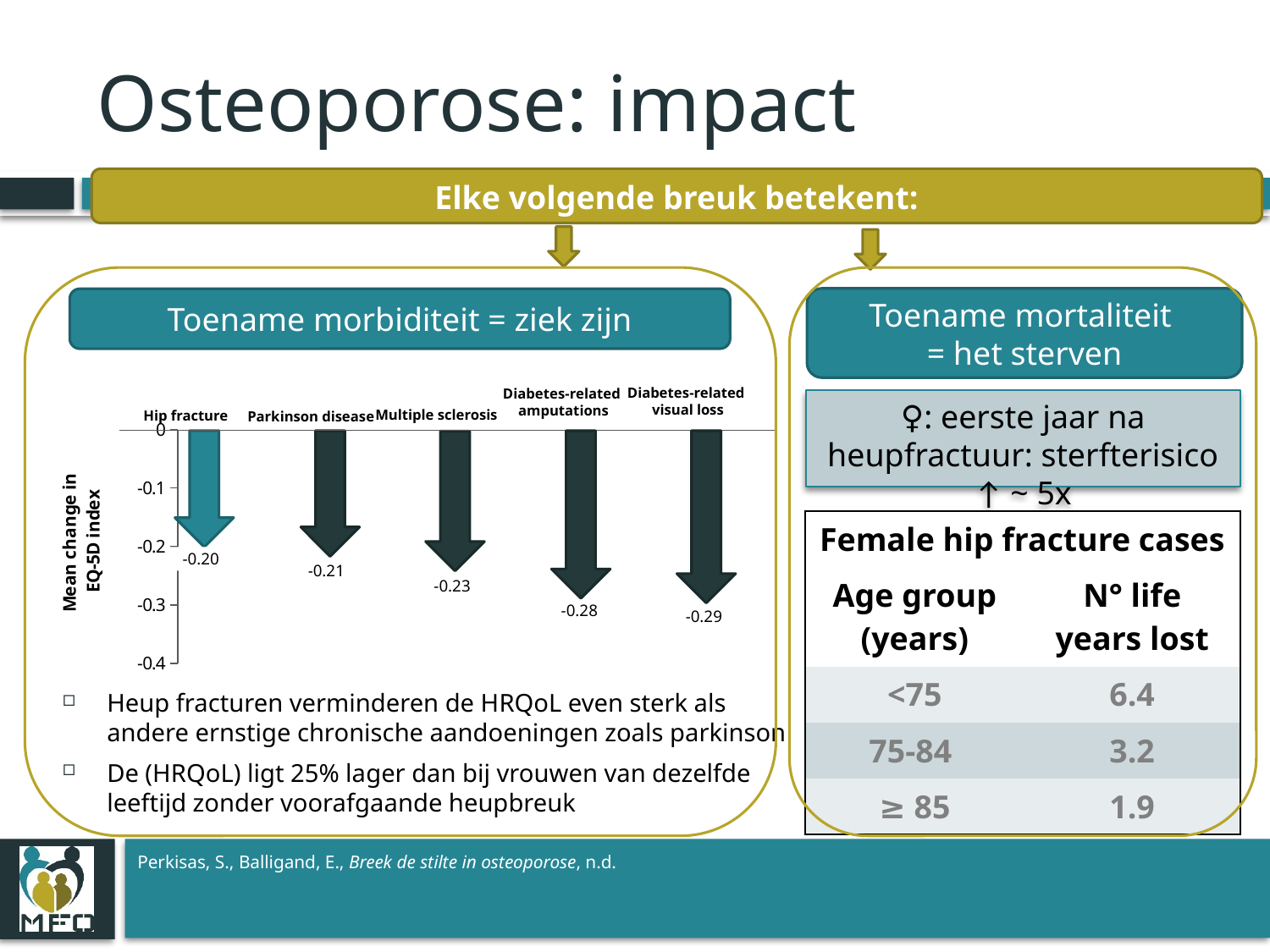
What type of chart is used to show the mean change in EQ-5D index? Bar chart Which condition shows the smallest decrease (least negative value) in the EQ-5D index? Hip fracture What is the mean change in EQ-5D index for Multiple sclerosis? -0.23 What is the mean change in EQ-5D index for Hip fracture? -0.20 How many conditions are plotted in the chart? 5 What is the difference between the values for Diabetes-related visual loss and Hip fracture? 0.09 Which condition shows the largest decrease (most negative value) in the EQ-5D index? Diabetes-related visual loss What is the label of the vertical axis of the chart? Mean change in EQ-5D index What is the mean change in EQ-5D index for Diabetes-related amputations? -0.28 What is the mean change in EQ-5D index for Parkinson disease? -0.21 What is the mean change in EQ-5D index for Diabetes-related visual loss? -0.29 Which has a larger decrease in EQ-5D index, Multiple sclerosis or Diabetes-related amputations? Diabetes-related amputations